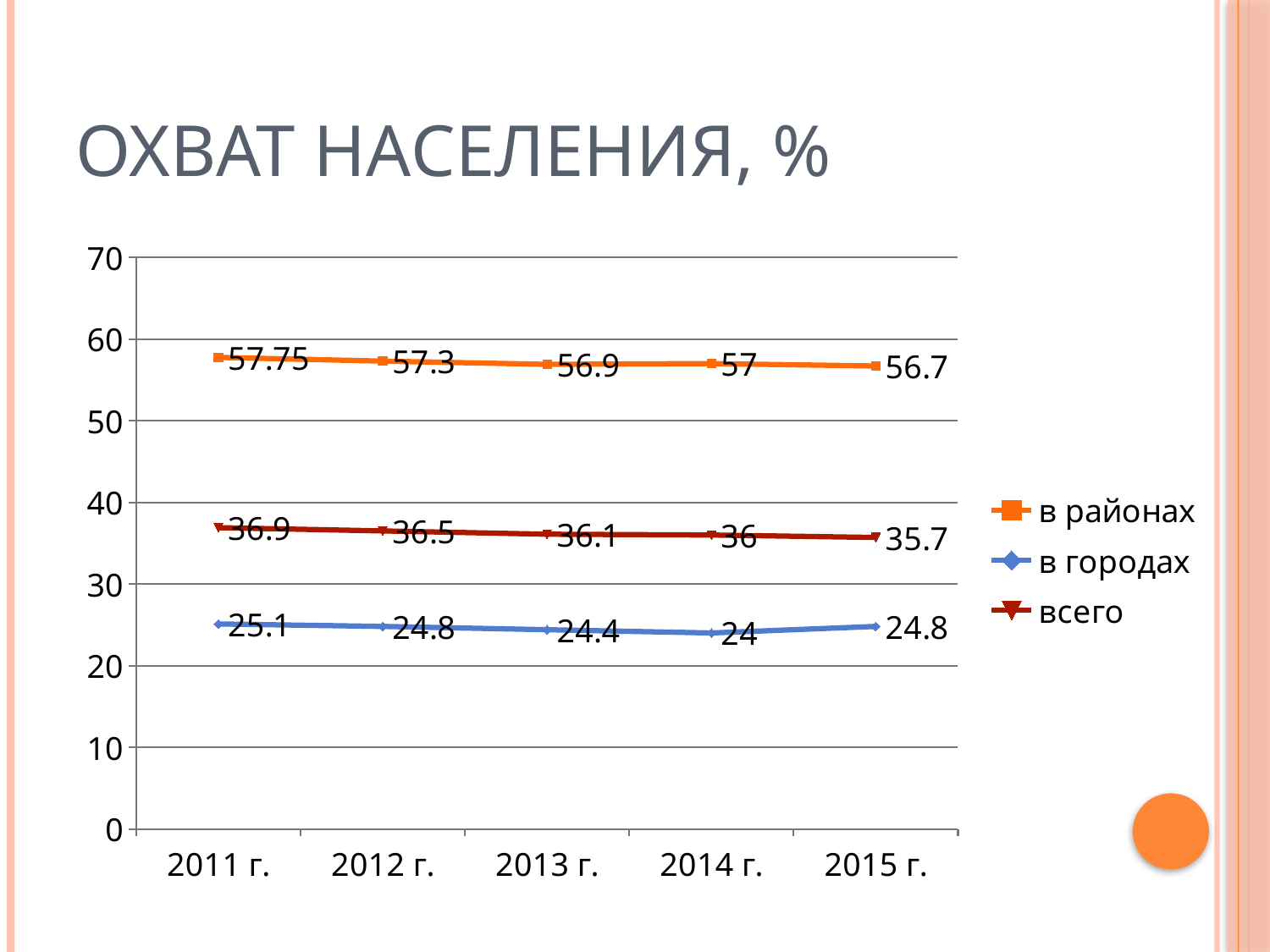
What kind of chart is shown on the slide? line chart What is the difference between the "в районах" and "в городах" values in 2013 г.? 32.5 Which is larger in 2012 г.: the value for "всего" or the value for "в городах"? всего In which year is the value for "в районах" highest? 2011 г. What is the value for "в городах" in 2014 г.? 24 In which year is the value for "в городах" lowest? 2014 г. What is the value for "в районах" in 2011 г.? 57.75 How many series does the legend list? 3 What is the value for "всего" in 2015 г.? 35.7 Is the value for "в районах" in 2015 г. greater or less than 50? greater Does the value for "всего" rise or fall from 2011 г. to 2015 г.? fall How many years are shown on the x axis? 5